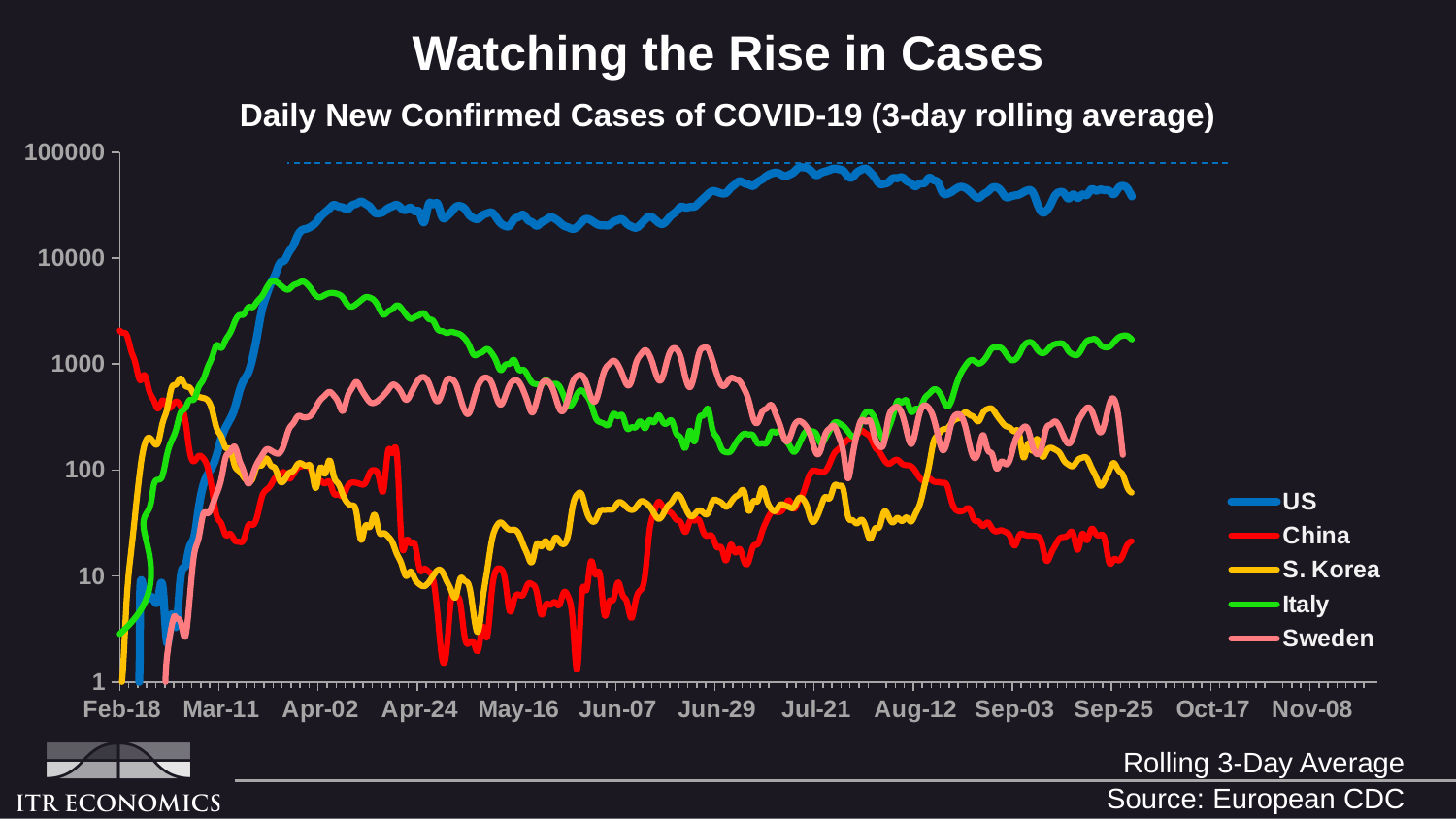
Is the value for Italy at Sep-25 greater or less than 1000? greater Which series has the lowest value at Sep-25? China Which countries are listed in the legend? US, China, S. Korea, Italy, Sweden Does the US series rise or fall between Feb-18 and Apr-02? Rise At Sep-25, which is larger, the value for Italy or the value for S. Korea? Italy Is the value for China at Sep-25 greater or less than 100? less Is the value for the US around Jul-21 greater or less than 10000? greater Does the Italy series rise or fall between Apr-02 and Jun-29? Fall What is the source cited for the chart data? European CDC Which series has the highest value at Sep-25? US How many series does the legend list? 5 What kind of chart is shown on the slide? Line chart